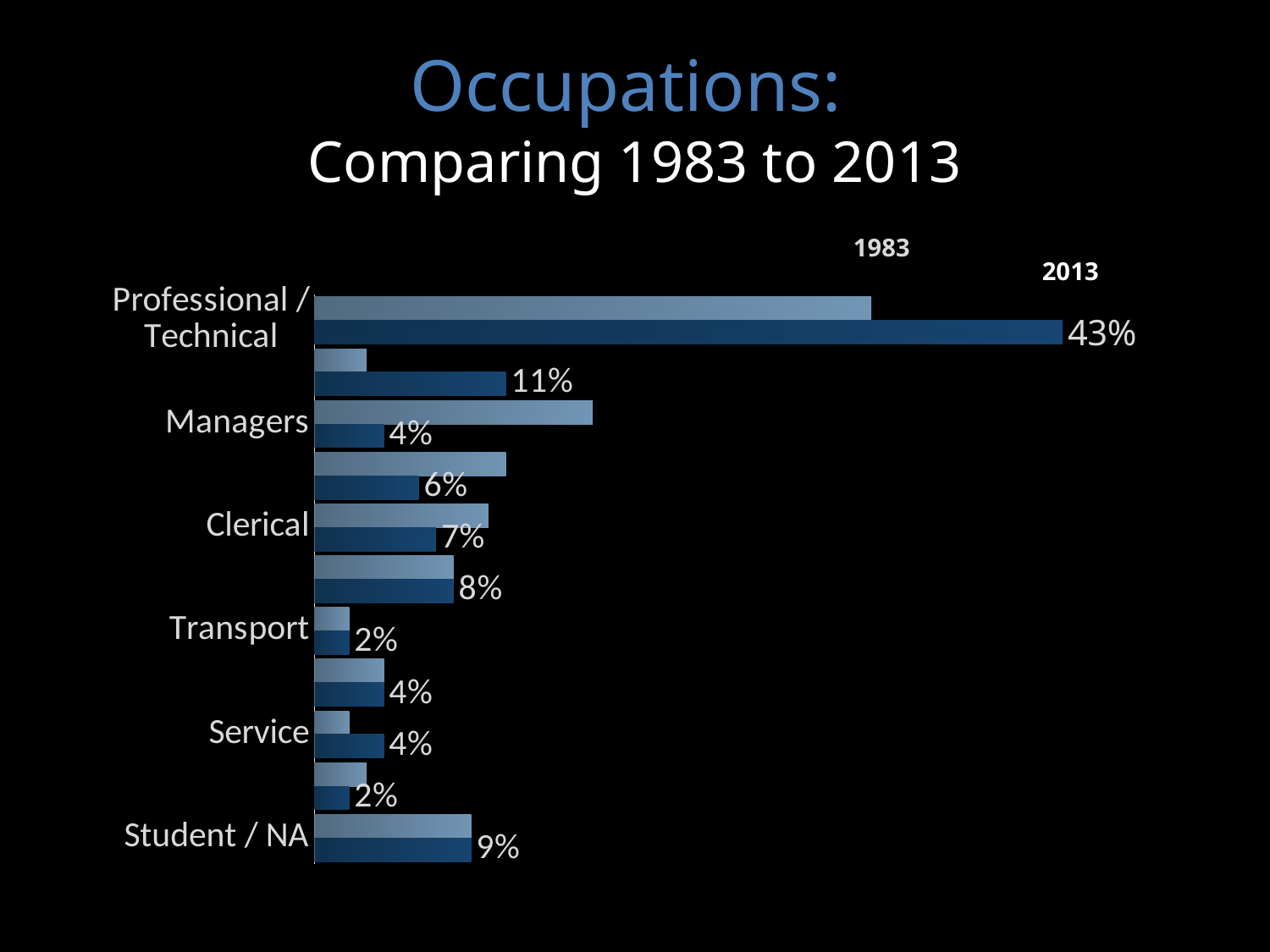
Which is larger in 2013, Clerical or Managers? Clerical What is the 2013 value for Clerical? 7% What is the 2013 value for Student / NA? 9% What is the title of the slide? Occupations: Comparing 1983 to 2013 What is the difference between the 2013 values for Professional / Technical and Student / NA? 34 percentage points For Managers, which series has the larger value, 1983 or 2013? 1983 What is the 2013 value for Transport? 2% What kind of chart is shown on the slide? bar chart What is the 2013 value for Managers? 4% Which labeled category has the highest 2013 value? Professional / Technical What is the 2013 value for Professional / Technical? 43%